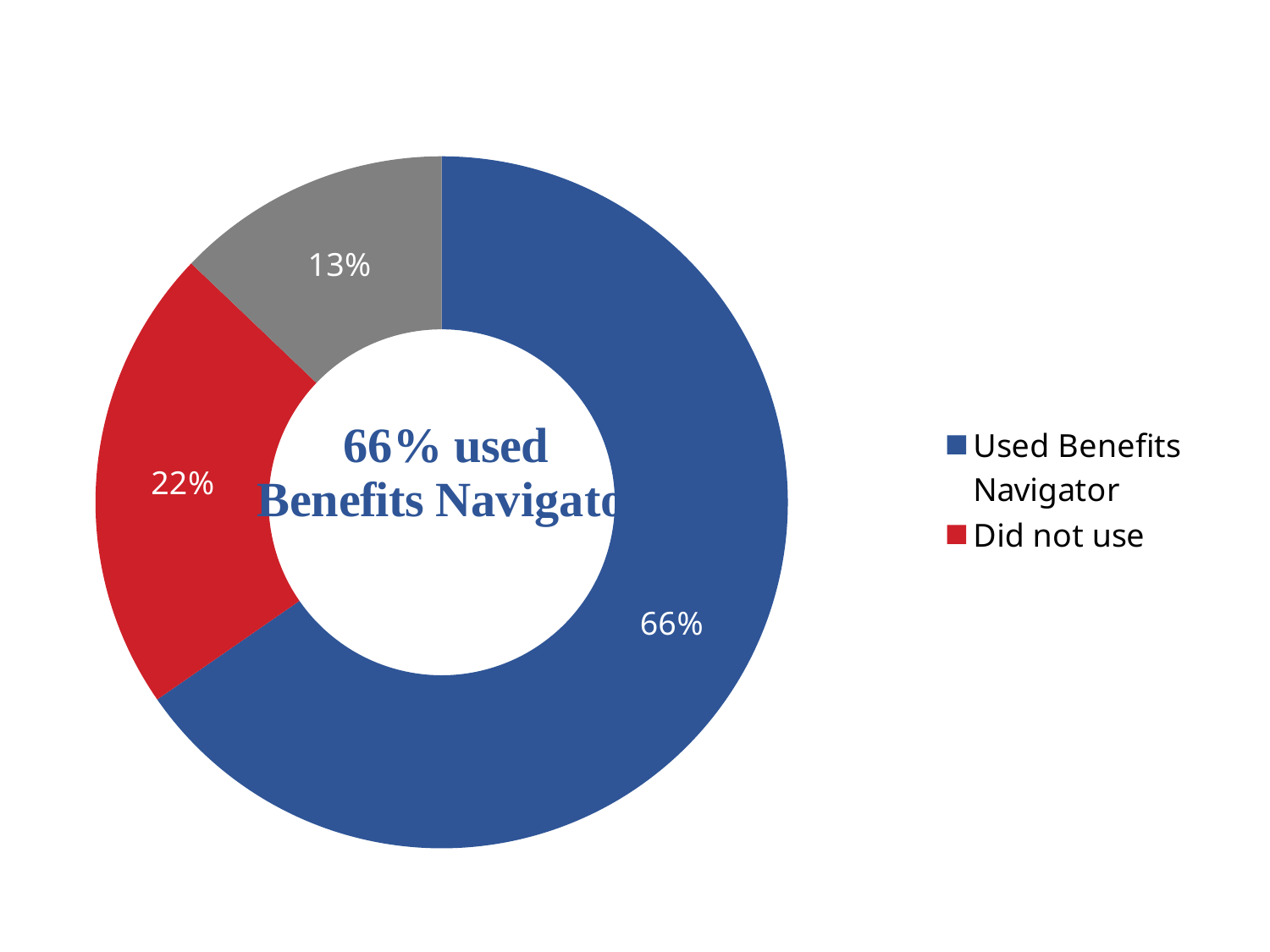
How many slices does the chart have? 3 Which category has the largest slice of the chart? Used Benefits Navigator How many entries does the legend list? 2 What percentage of the chart is labelled for Used Benefits Navigator? 66% What percentage is shown for the Did not use slice? 22% What kind of chart is shown on the slide? Pie (donut) chart By how many percentage points does Used Benefits Navigator exceed Did not use? 44 percentage points What colour represents Did not use in the chart? Red What is the smallest percentage shown on the chart? 13% What text is written in the centre of the donut chart? 66% used Benefits Navigator Which is larger, the Did not use slice or the gray slice? Did not use What percentage is shown on the gray slice of the chart? 13%